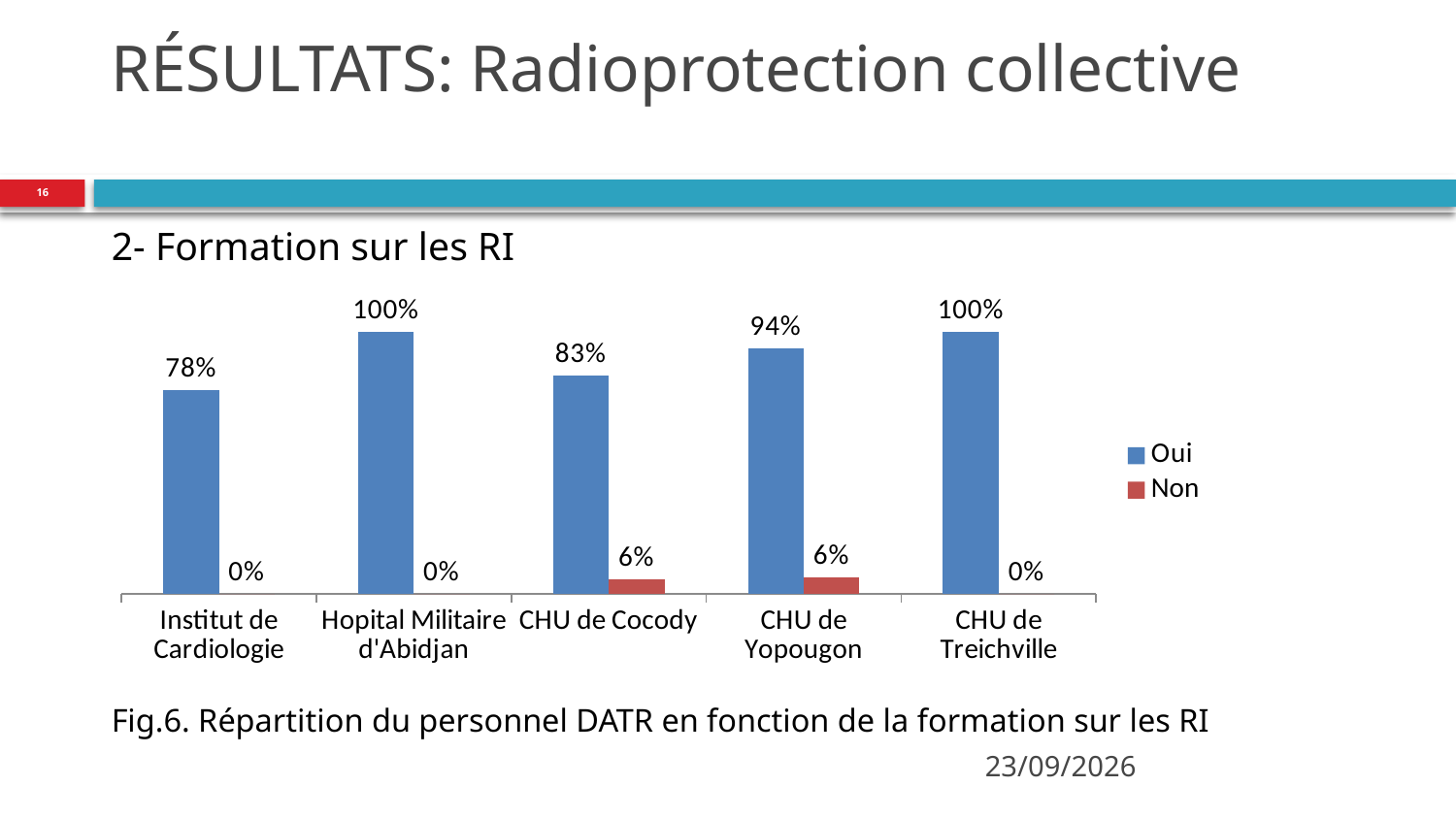
Which series is shown in blue? Oui Which category has the lowest 'Oui' value? Institut de Cardiologie What is the 'Non' value for CHU de Cocody? 6% What is the difference between the 'Oui' values for Hopital Militaire d'Abidjan and CHU de Cocody? 17% What is the 'Oui' value for Institut de Cardiologie? 78% What is the caption of the figure? Fig.6. Répartition du personnel DATR en fonction de la formation sur les RI How many categories are shown on the x axis? 5 Which is larger, the 'Oui' value for CHU de Yopougon or for CHU de Cocody? CHU de Yopougon What kind of chart is shown on the slide? Bar chart How many series does the legend list? 2 What is the 'Oui' value for CHU de Yopougon? 94% What is the 'Non' value for CHU de Treichville? 0%